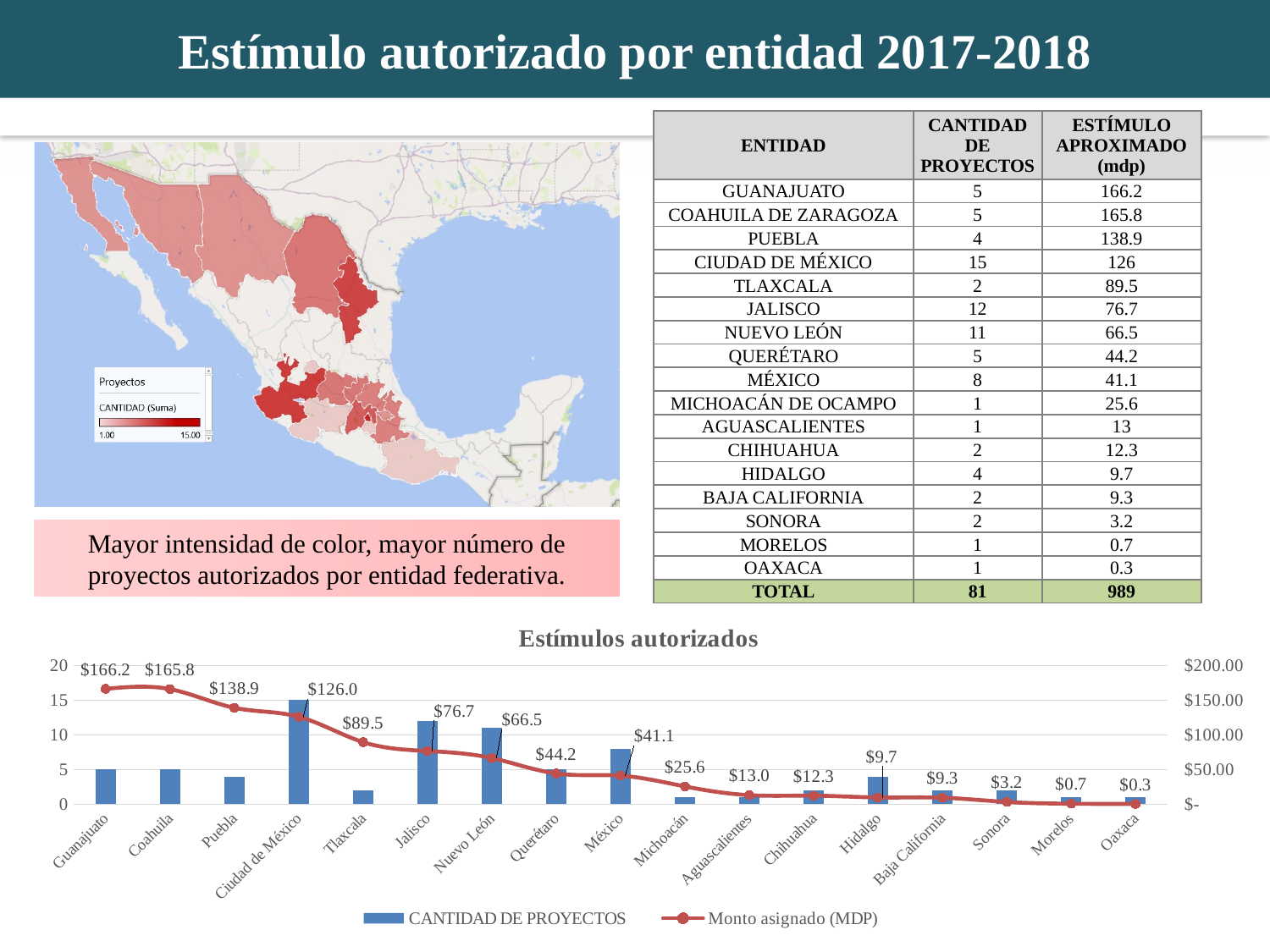
In the 'Estímulos autorizados' chart, what is the difference between the Monto asignado for Puebla and for Tlaxcala? $49.4 In the 'Estímulos autorizados' chart, what is the Monto asignado (MDP) for Puebla? $138.9 How many series does the legend of the 'Estímulos autorizados' chart list? 2 In the 'Estímulos autorizados' chart, does the Monto asignado (MDP) line rise or fall from left to right along the x axis? It falls In the 'Estímulos autorizados' chart, which entity has the highest Monto asignado (MDP)? Guanajuato In the 'Estímulos autorizados' chart, how many CANTIDAD DE PROYECTOS does the bar for Ciudad de México show? 15 In the 'Estímulos autorizados' chart, is the CANTIDAD DE PROYECTOS bar for Jalisco greater or less than 10? greater In the 'Estímulos autorizados' chart, which entity has the lowest Monto asignado (MDP)? Oaxaca How many entities are shown on the x axis of the 'Estímulos autorizados' chart? 17 In the 'Estímulos autorizados' chart, what is the Monto asignado (MDP) for Jalisco? $76.7 What kind of chart is 'Estímulos autorizados'? A combination bar and line chart In the 'Estímulos autorizados' chart, which has a larger Monto asignado: Hidalgo or Baja California? Hidalgo